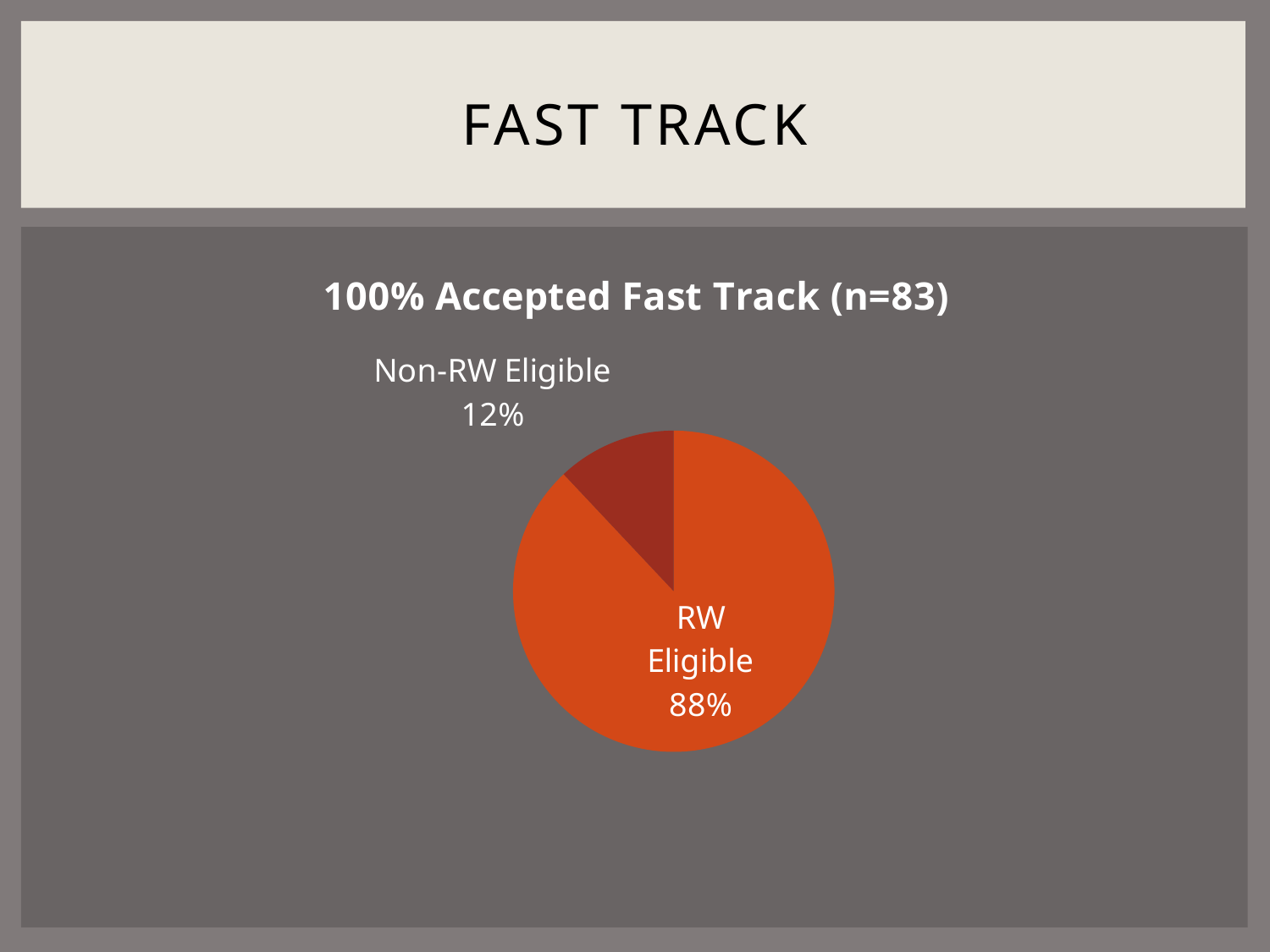
What is the sample size (n) stated in the chart title? 83 What is the difference in percentage points between the RW Eligible and Non-RW Eligible slices? 76 How many slices does the pie chart have? 2 Which is larger, the RW Eligible slice or the Non-RW Eligible slice? RW Eligible Which slice of the pie is the largest? RW Eligible What share of the pie does the Non-RW Eligible slice represent? 12% Which slice of the pie is the smallest? Non-RW Eligible What percentage of the pie is RW Eligible? 88% What percentage of the pie is Non-RW Eligible? 12% What is the title of the chart? 100% Accepted Fast Track (n=83) What kind of chart is shown on the slide? pie chart